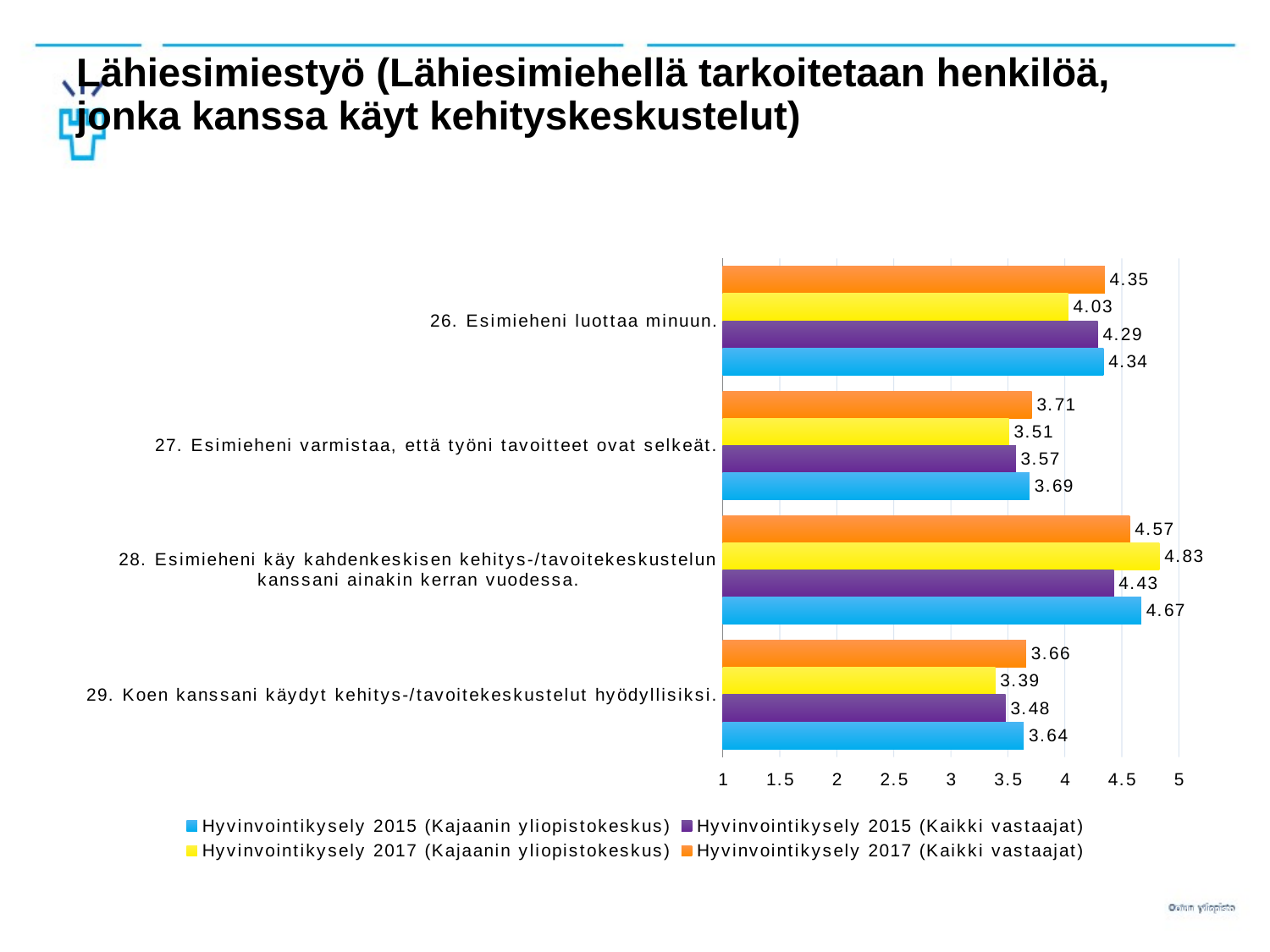
What is the value for Hyvinvointikysely 2017 (Kaikki vastaajat) for item 29 (Koen kanssani käydyt kehitys-/tavoitekeskustelut hyödyllisiksi)? 3.66 Which colour represents Hyvinvointikysely 2017 (Kaikki vastaajat) in the chart? orange What is the value for Hyvinvointikysely 2017 (Kajaanin yliopistokeskus) for item 28 (Esimieheni käy kahdenkeskisen kehitys-/tavoitekeskustelun kanssani ainakin kerran vuodessa)? 4.83 What is the difference between the Hyvinvointikysely 2017 (Kajaanin yliopistokeskus) and Hyvinvointikysely 2015 (Kajaanin yliopistokeskus) values for item 26 (Esimieheni luottaa minuun)? 0.31 What kind of chart is shown on the slide? bar chart What is the value for Hyvinvointikysely 2015 (Kaikki vastaajat) for item 26 (Esimieheni luottaa minuun)? 4.29 How many series does the legend list? 4 Which item has the highest value for Hyvinvointikysely 2015 (Kajaanin yliopistokeskus)? 28. Esimieheni käy kahdenkeskisen kehitys-/tavoitekeskustelun kanssani ainakin kerran vuodessa. Is the value for Hyvinvointikysely 2015 (Kaikki vastaajat) for item 29 greater or less than 3.5? less Which item has the lowest value for Hyvinvointikysely 2017 (Kajaanin yliopistokeskus)? 29. Koen kanssani käydyt kehitys-/tavoitekeskustelut hyödyllisiksi. For item 27 (Esimieheni varmistaa, että työni tavoitteet ovat selkeät), which is larger: the Hyvinvointikysely 2017 (Kaikki vastaajat) value or the Hyvinvointikysely 2017 (Kajaanin yliopistokeskus) value? Hyvinvointikysely 2017 (Kaikki vastaajat) How many categories (questions) are shown on the chart? 4